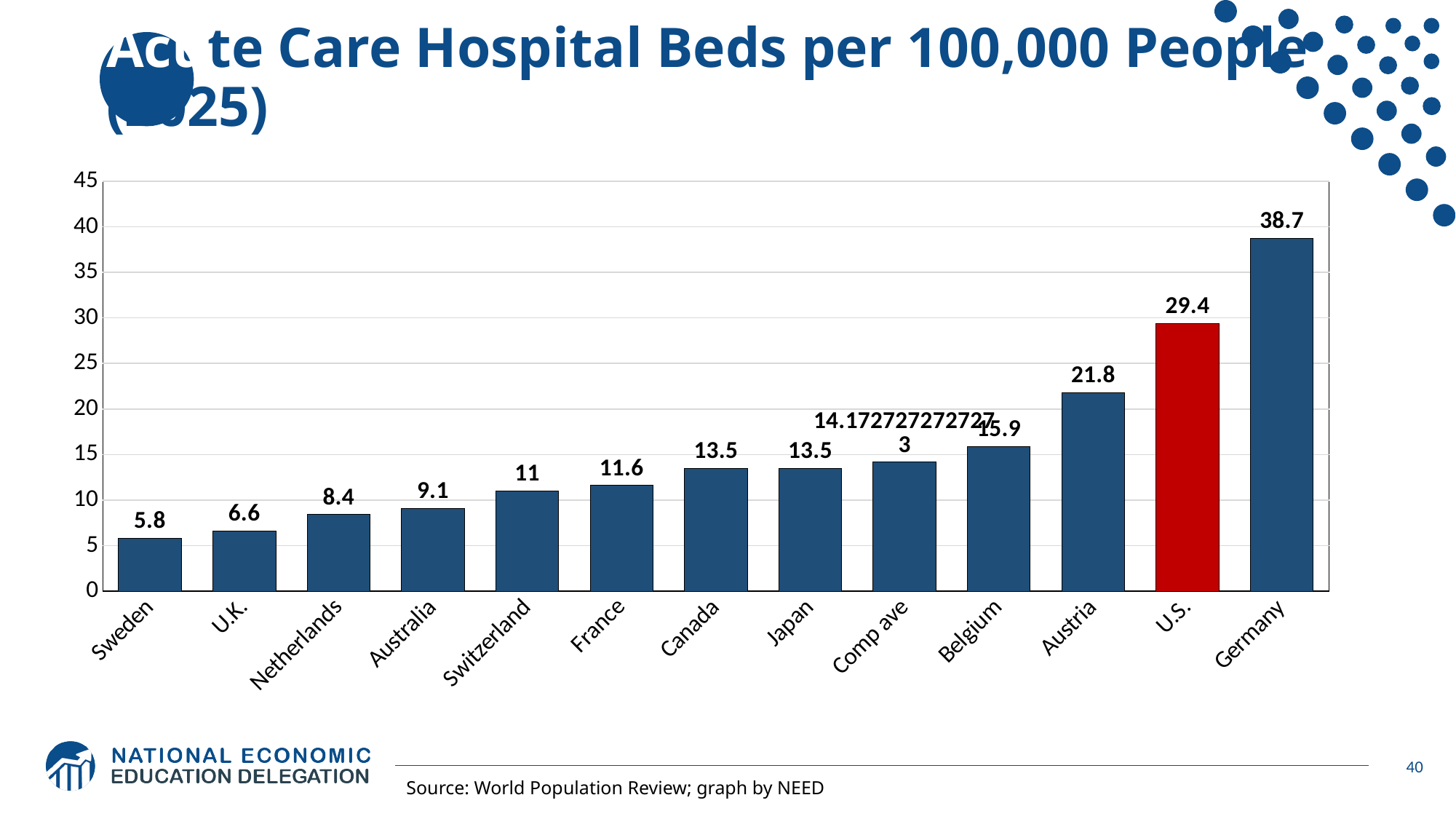
What is the value for Sweden? 5.8 Which country has the lowest value? Sweden What is the value for Germany? 38.7 What is the value for the U.S.? 29.4 Which country has the highest value? Germany Which has a larger value, France or Netherlands? France What kind of chart is shown on the slide? Bar chart What is the value for Belgium? 15.9 What is the difference between the values for Germany and the U.S.? 9.3 What is the difference between the values for Austria and Belgium? 5.9 Which bar is coloured red rather than blue? U.S. How many countries or categories are shown on the x axis? 13